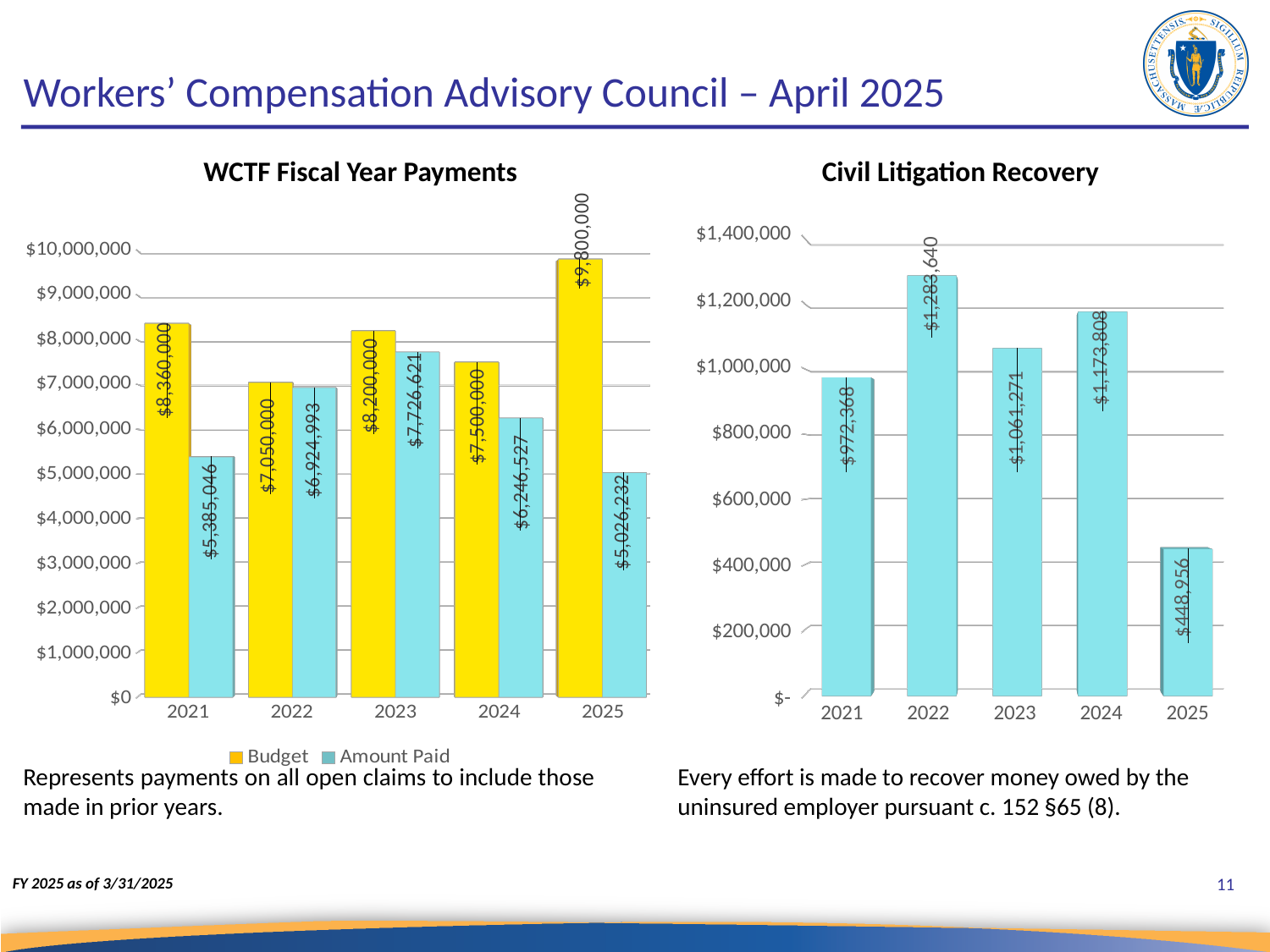
In the WCTF Fiscal Year Payments chart, what is the Amount Paid for 2022? $6,924,993 In the Civil Litigation Recovery chart, what is the value for 2024? $1,173,808 In the Civil Litigation Recovery chart, how many years are shown on the x axis? 5 What kind of chart is the Civil Litigation Recovery chart? Bar chart In the WCTF Fiscal Year Payments chart, which is larger: the Amount Paid in 2021 or the Amount Paid in 2024? Amount Paid in 2024 In the Civil Litigation Recovery chart, which year has the highest recovery? 2022 In the WCTF Fiscal Year Payments chart, what is the Budget value for 2025? $9,800,000 In the WCTF Fiscal Year Payments chart, which year has the highest Budget? 2025 In the Civil Litigation Recovery chart, what is the difference between the 2022 and 2025 values? $834,684 In the WCTF Fiscal Year Payments chart, which year has the lowest Amount Paid? 2025 In the WCTF Fiscal Year Payments chart, what is the difference between the Budget and the Amount Paid in 2023? $473,379 In the WCTF Fiscal Year Payments chart, how many series does the legend list? 2